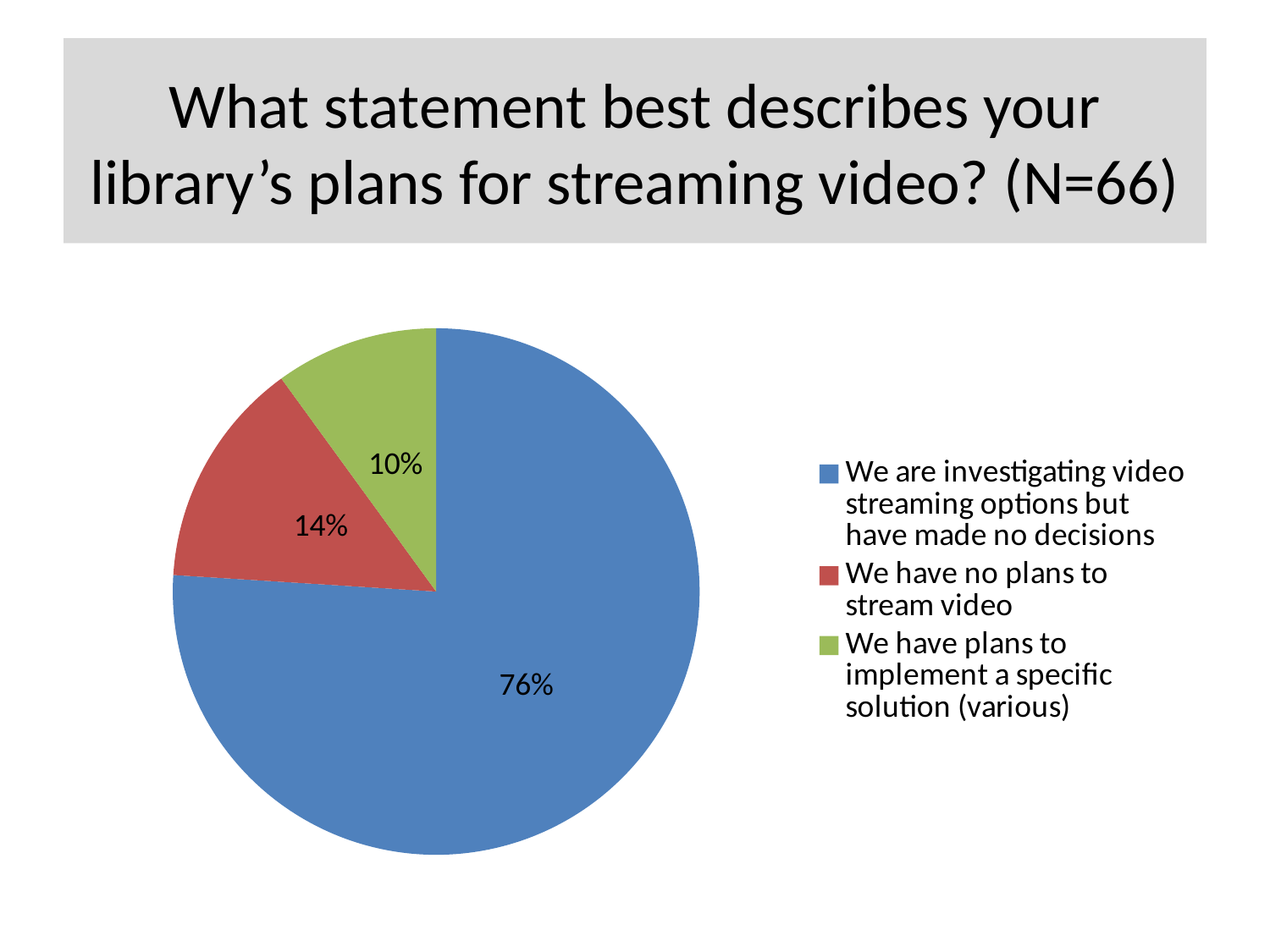
What colour is the slice for 'We have no plans to stream video'? Red Which is larger: the slice for 'We have no plans to stream video' or the slice for 'We have plans to implement a specific solution (various)'? We have no plans to stream video How many categories does the pie chart show? 3 What is the difference in percentage points between the largest slice and the 'We have no plans to stream video' slice? 62 percentage points What is the sample size (N) stated in the slide title? 66 Which category has the smallest slice of the pie? We have plans to implement a specific solution (various) What kind of chart is shown on the slide? Pie chart Which category has the largest slice of the pie? We are investigating video streaming options but have made no decisions What share of the pie is labelled for 'We have plans to implement a specific solution (various)'? 10% What share of the pie is labelled for 'We are investigating video streaming options but have made no decisions'? 76% What is the difference in percentage points between the 'We have no plans to stream video' slice and the 'We have plans to implement a specific solution (various)' slice? 4 percentage points What share of the pie is labelled for 'We have no plans to stream video'? 14%